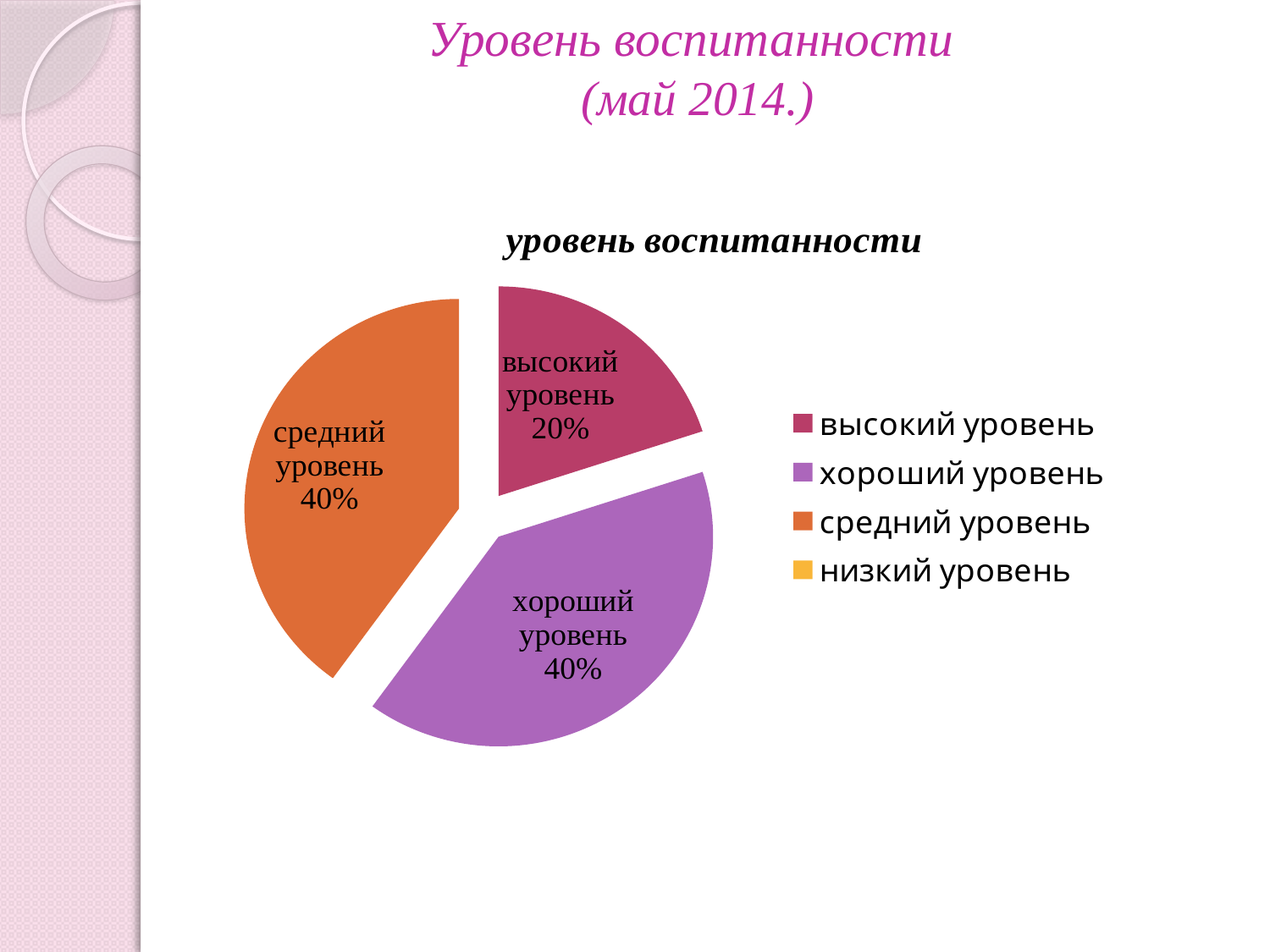
What share of the pie does хороший уровень have? 40% Which is larger, the slice for хороший уровень or the slice for высокий уровень? хороший уровень What is the combined share of the three labelled slices? 100% What kind of chart is shown on the slide? pie chart How many entries does the chart legend list? 4 How many slices are shown in the pie? 3 Among the slices shown in the pie, which one is the smallest? высокий уровень What is the difference in percentage points between the slices for средний уровень and высокий уровень? 20 What is the title of the chart? уровень воспитанности What share of the pie does средний уровень have? 40% What share of the pie does высокий уровень have? 20%